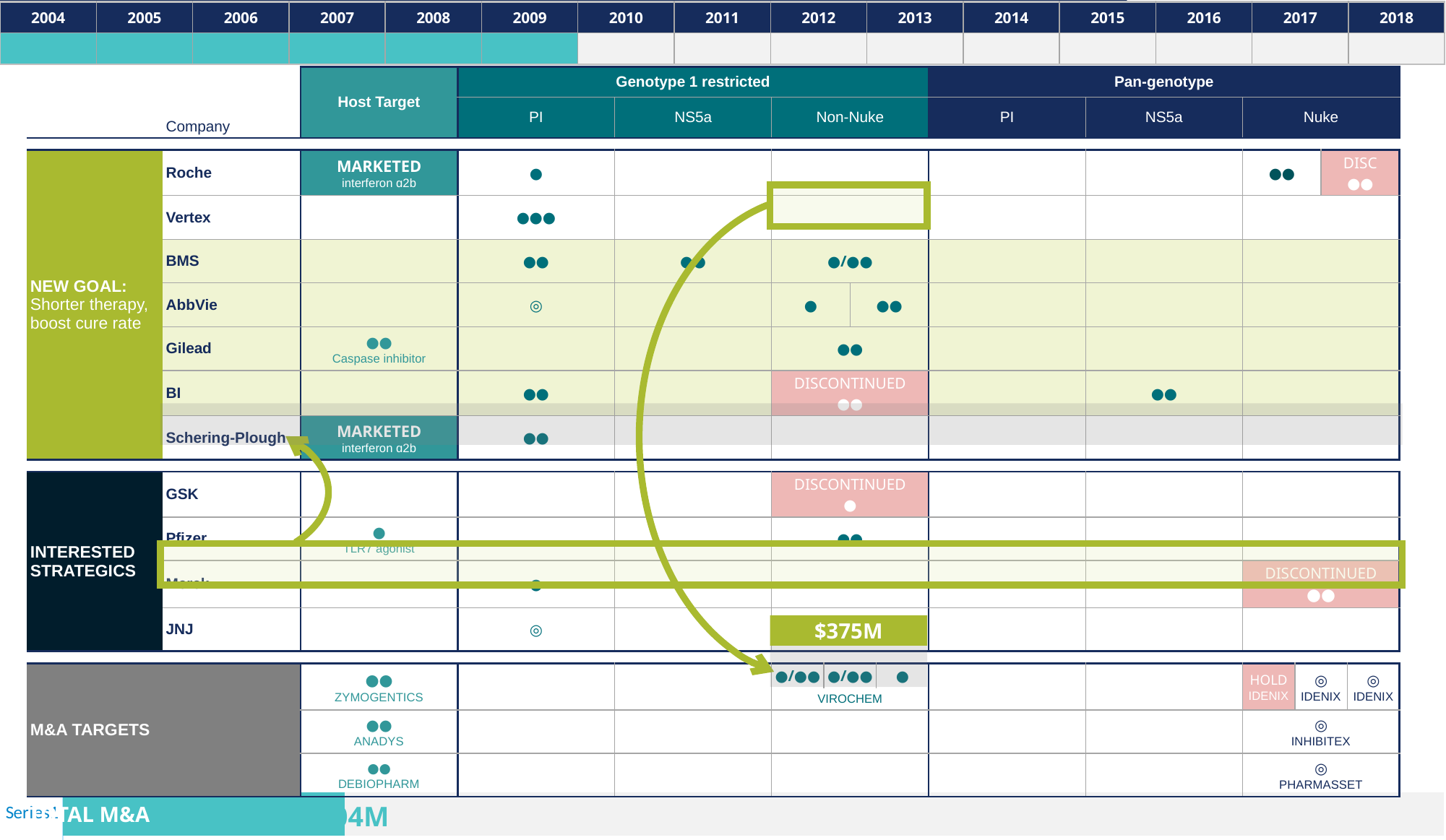
How many years are shown along the timeline at the top of the slide? 15 How many years on the top timeline are shaded teal? 6 What dollar value is highlighted in the Non-Nuke column for the JNJ row? $375M What is the first year shown on the timeline at the top of the slide? 2004 Through which year does the teal shaded portion of the top timeline extend? 2009 What series name appears in the legend at the bottom left of the slide? Series1 What is the last year shown on the timeline at the top of the slide? 2018 How many series does the legend at the bottom left of the slide list? 1